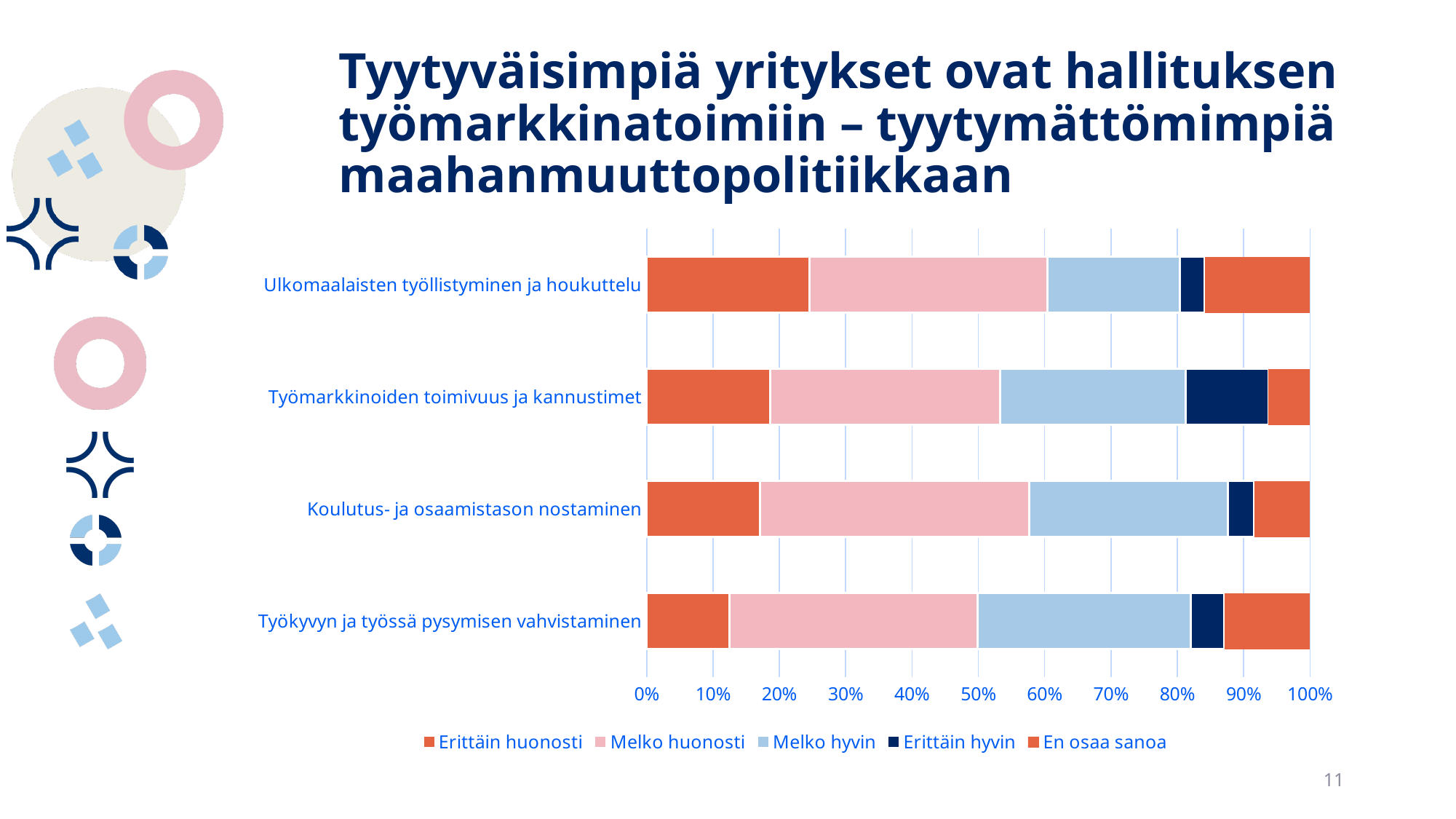
What is the first entry listed in the chart legend? Erittäin huonosti How many series does the legend list? 5 What kind of chart is shown on the slide? Stacked bar chart Which has the larger 'Melko hyvin' segment: Työkyvyn ja työssä pysymisen vahvistaminen or Ulkomaalaisten työllistyminen ja houkuttelu? Työkyvyn ja työssä pysymisen vahvistaminen How many categories (policy areas) are plotted on the chart? 4 Which category has the smallest 'Erittäin huonosti' segment? Työkyvyn ja työssä pysymisen vahvistaminen Is the 'Erittäin huonosti' share for Ulkomaalaisten työllistyminen ja houkuttelu greater or less than 20%? greater Which has the larger 'En osaa sanoa' segment: Ulkomaalaisten työllistyminen ja houkuttelu or Työmarkkinoiden toimivuus ja kannustimet? Ulkomaalaisten työllistyminen ja houkuttelu Which category has the largest 'Erittäin hyvin' segment? Työmarkkinoiden toimivuus ja kannustimet Which category has the largest 'Erittäin huonosti' segment? Ulkomaalaisten työllistyminen ja houkuttelu Is the 'Erittäin huonosti' share for Työkyvyn ja työssä pysymisen vahvistaminen greater or less than 20%? less Is the 'Melko hyvin' share for Koulutus- ja osaamistason nostaminen greater or less than 20%? greater